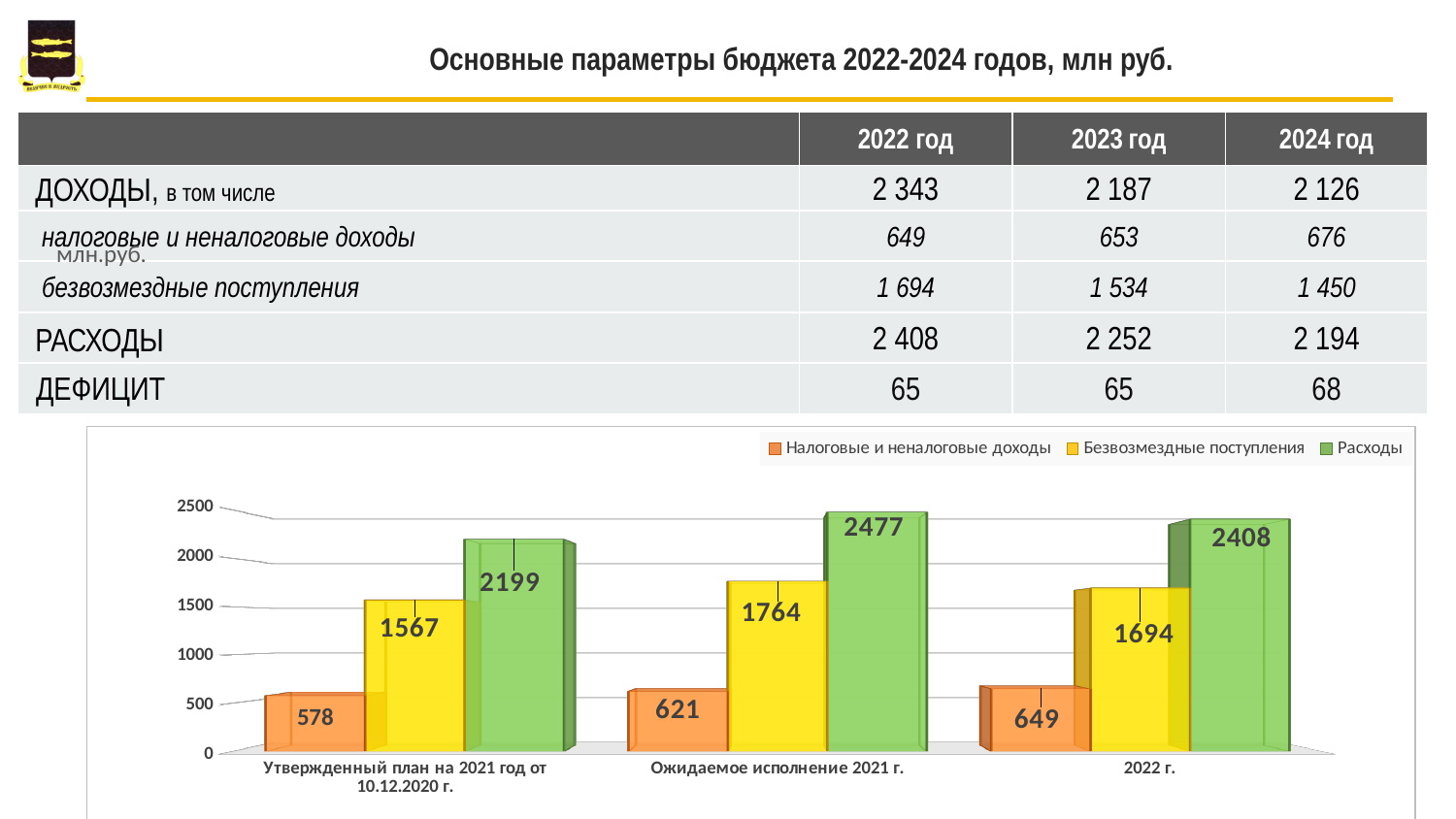
What is the value of Расходы for Ожидаемое исполнение 2021 г.? 2477 What is the value of Безвозмездные поступления for Утвержденный план на 2021 год от 10.12.2020 г.? 1567 Do the values of Налоговые и неналоговые доходы rise or fall from left to right along the x axis? rise Which category has the lowest value for Налоговые и неналоговые доходы? Утвержденный план на 2021 год от 10.12.2020 г. How many categories are shown on the x axis of the chart? 3 What is the difference between Расходы for 2022 г. and Расходы for Утвержденный план на 2021 год от 10.12.2020 г.? 209 How many series does the chart legend list? 3 Which colour represents Расходы in the chart legend? green What kind of chart is shown on the slide? bar chart What is the value of Налоговые и неналоговые доходы for 2022 г.? 649 Which category has the highest value for Расходы? Ожидаемое исполнение 2021 г. Which is larger: Безвозмездные поступления for Ожидаемое исполнение 2021 г. or for 2022 г.? Ожидаемое исполнение 2021 г.